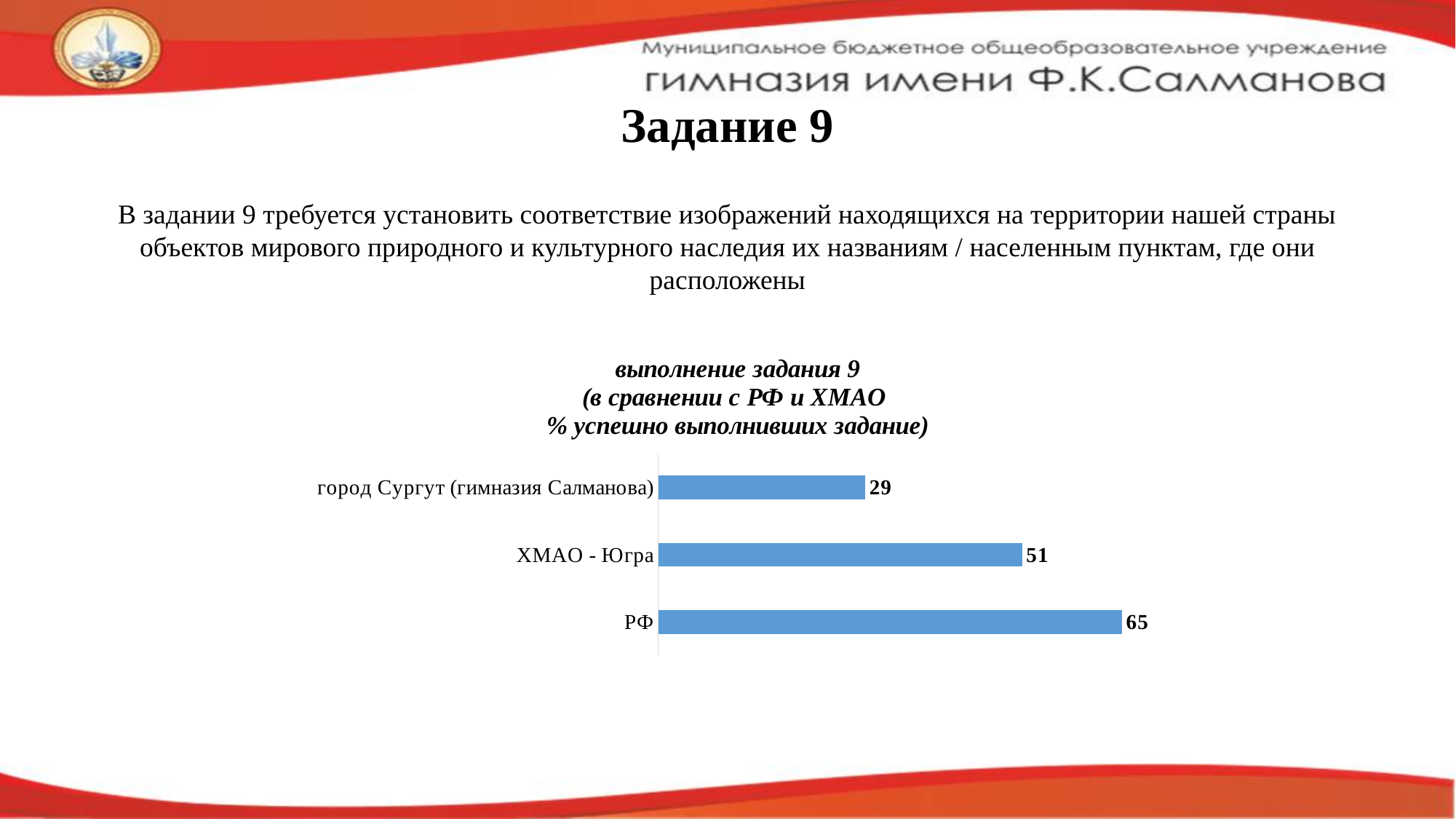
Which category has the highest value? РФ What is the difference between the values for РФ and ХМАО - Югра? 14 What is the title of the chart? выполнение задания 9 (в сравнении с РФ и ХМАО % успешно выполнивших задание) What is the value for ХМАО - Югра? 51 What is the value for город Сургут (гимназия Салманова)? 29 Which category has the lowest value? город Сургут (гимназия Салманова) What kind of chart is shown on the slide? bar chart Which is larger, the value for ХМАО - Югра or the value for город Сургут (гимназия Салманова)? ХМАО - Югра What is the difference between the values for ХМАО - Югра and город Сургут (гимназия Салманова)? 22 What colour are the bars in the chart? blue What is the value for РФ? 65 How many categories are shown in the chart? 3